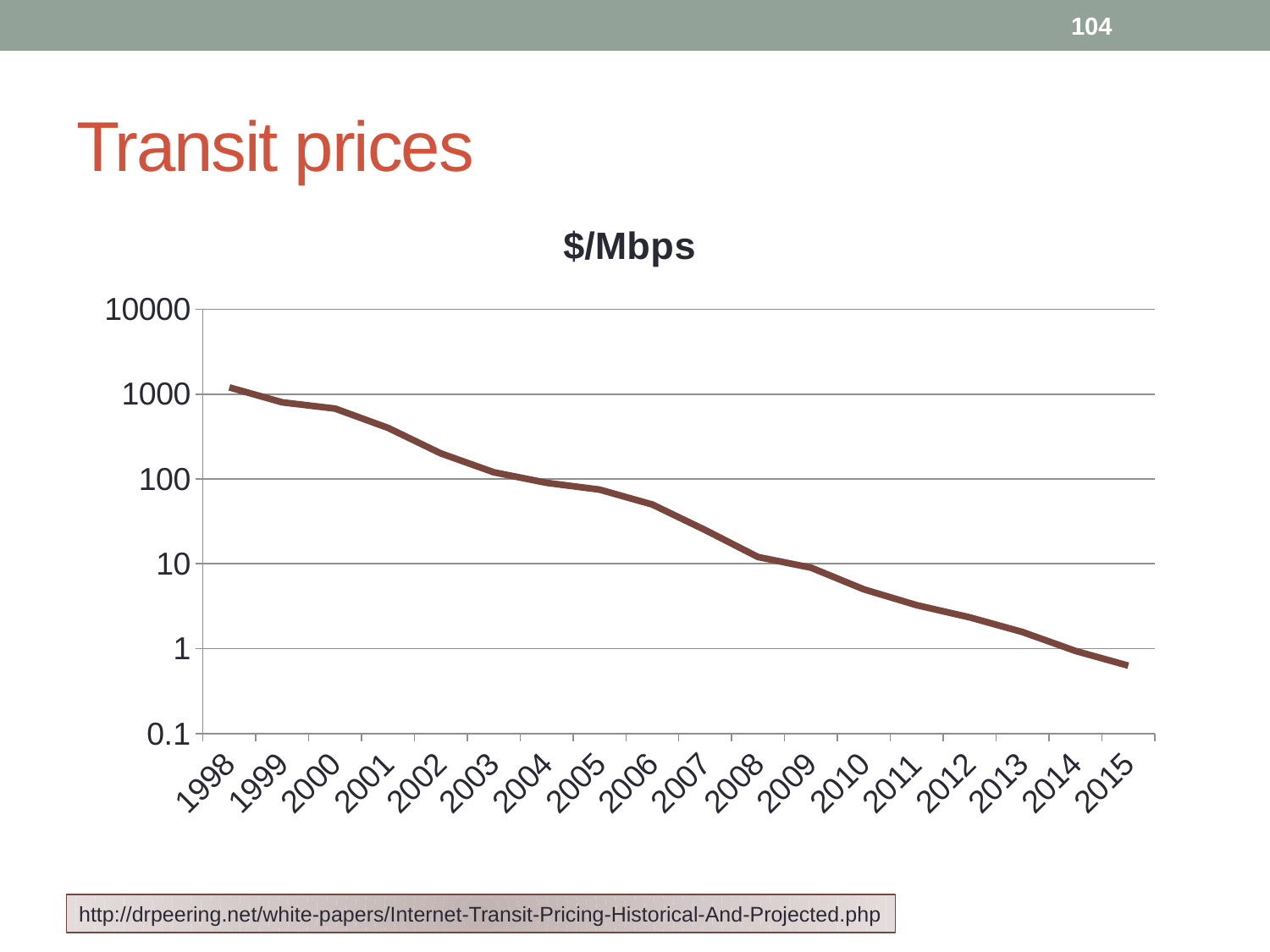
Which year has the lowest value? 2015 What is the title of the chart? $/Mbps Which year has the highest value? 1998 Is the value for 2015 greater or less than 1? less What kind of chart is shown on the slide? line chart Is the value for 2010 greater or less than 10? less Is the value for 2002 greater or less than 100? greater How many years are plotted along the x axis? 18 Do the values rise or fall from 1998 to 2015? fall Which is larger, the value for 2000 or the value for 2005? 2000